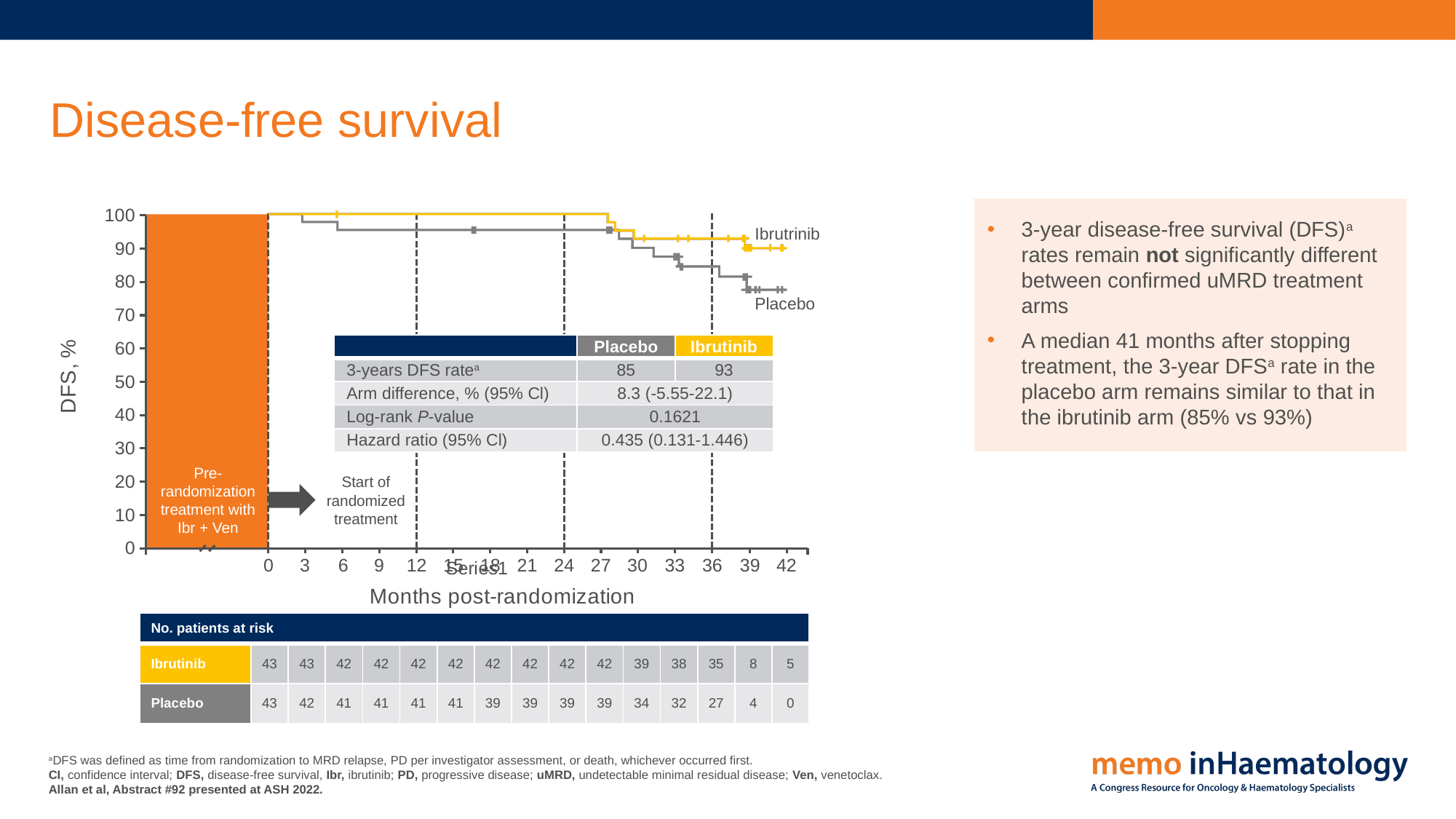
What is the hazard ratio (95% CI) shown on the chart? 0.435 (0.131-1.446) What is the 3-year DFS rate for the Ibrutinib arm? 93 What is the 3-year DFS rate for the Placebo arm? 85 What is the arm difference in 3-year DFS rate with its 95% CI? 8.3 (-5.55-22.1) Is the Ibrutinib curve at 42 months greater or less than 80? greater How many treatment arms (series) are plotted on the chart? 2 Is the Placebo curve at 36 months greater or less than 90? less Do the DFS curves rise or fall as months post-randomization increase? fall What is the log-rank P-value shown on the chart? 0.1621 What is the label of the x axis? Months post-randomization Which arm has the higher 3-year DFS rate, Placebo or Ibrutinib? Ibrutinib What kind of chart is shown on the slide? line chart